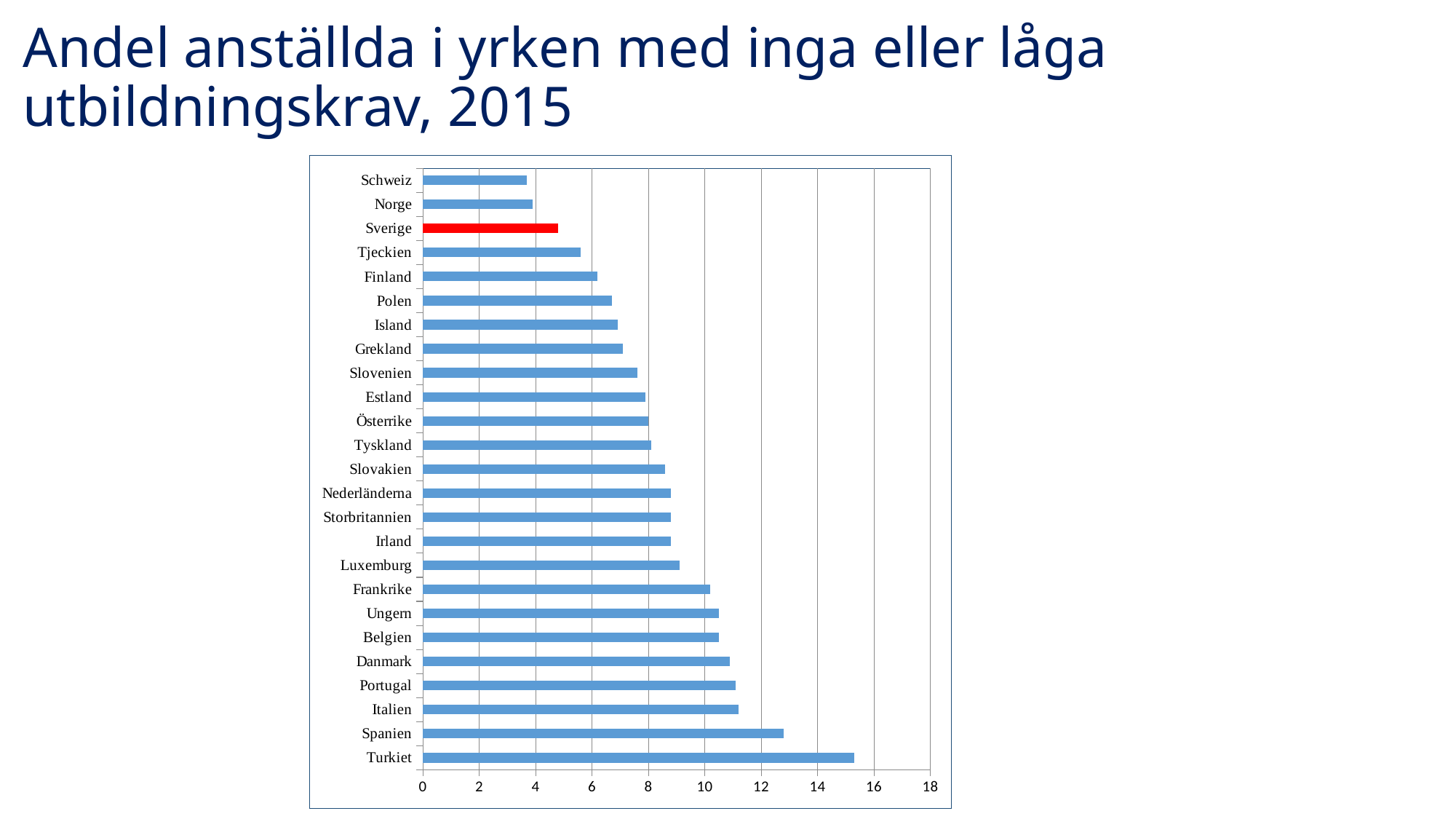
Is the value for Spanien greater or less than 12? greater Which has the larger value, Sverige or Tjeckien? Tjeckien What kind of chart is shown on the slide? bar chart Which has the larger value, Spanien or Italien? Spanien Which country has the highest value in the chart? Turkiet Which country's bar is coloured red in the chart? Sverige Is the value for Sverige greater or less than 6? less Is the value for Slovenien greater or less than 8? less How many countries are shown in the chart? 25